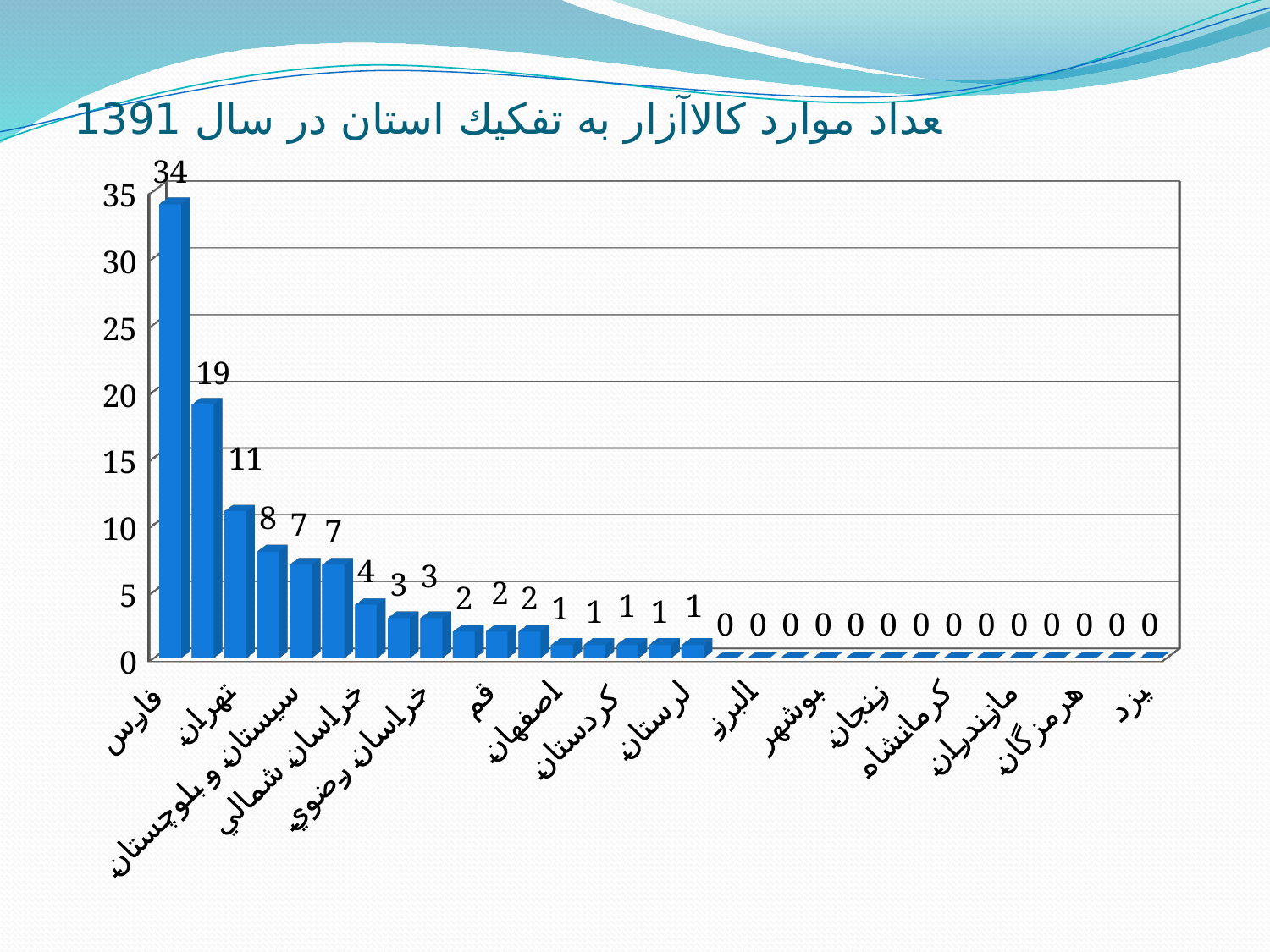
What is the highest tick value shown on the vertical axis? 35 Do the bar values rise or fall moving from left to right along the x axis? fall Is the value for فارس greater or less than 30? greater What is the value shown for فارس (the first bar)? 34 What is the difference between the highest bar (34) and the second-highest bar (19)? 15 What is the value of the second-highest bar in the chart? 19 Which is larger, the first bar (فارس) or the second bar? فارس Which province has the highest number of cases in the chart? فارس What is the value of the third bar from the left? 11 What type of chart is shown on the slide? bar chart How many bars have a data label of 7? 2 What is the lowest value shown by any bar in the chart? 0